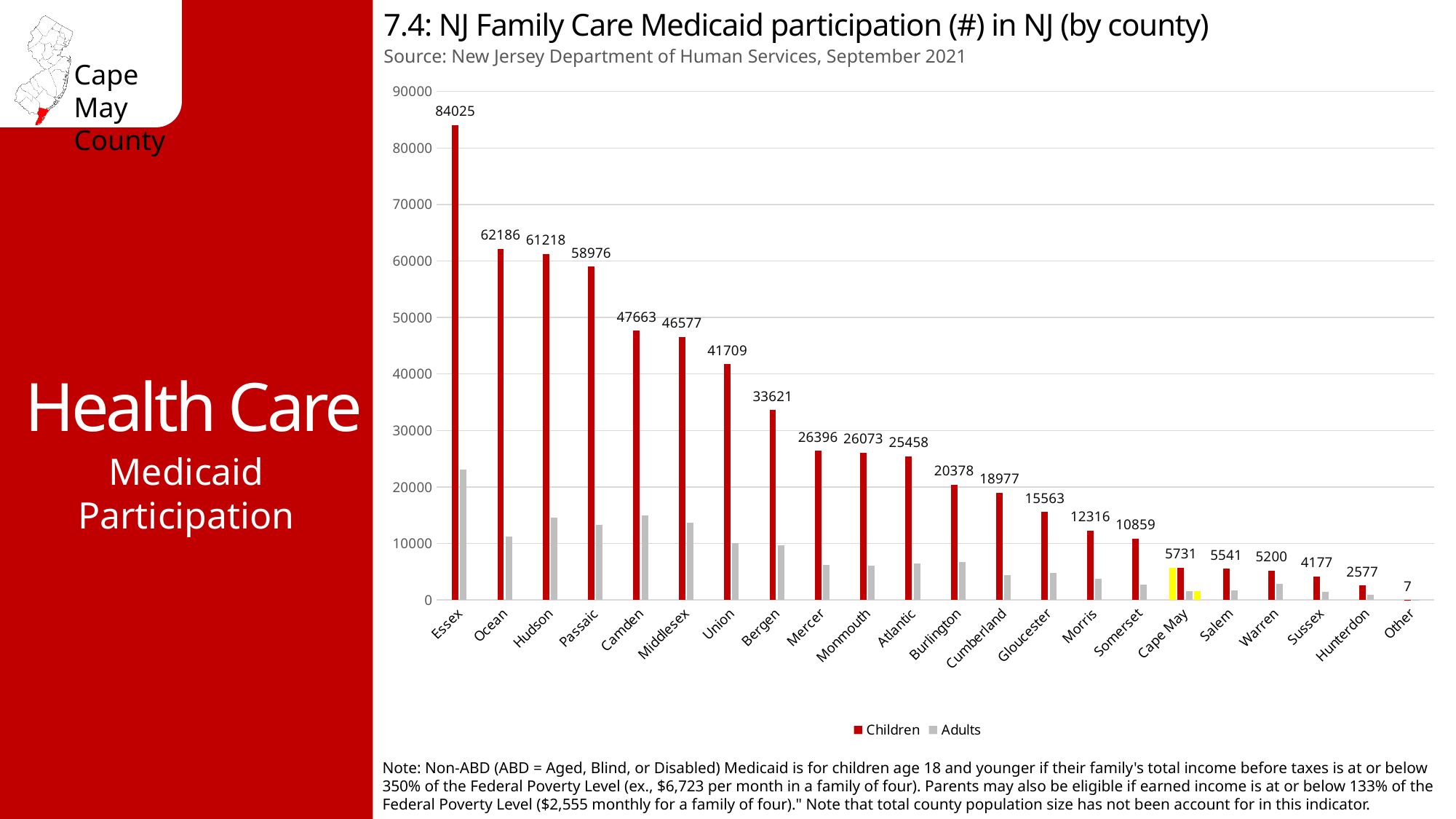
What kind of chart is shown? Bar chart What is the difference between the Children values for Ocean and Hudson? 968 Is the Adults value for Essex greater or less than 20000? greater What is the Children value for Essex? 84025 How many series does the legend list? 2 How many categories are shown on the x axis? 22 What is the Children value for Cape May? 5731 Is the Adults value for Hudson greater or less than 20000? less What is the Children value for Hunterdon? 2577 Which county has the highest Children value? Essex Which county has the lowest Children value (excluding Other)? Hunterdon Which has a larger Children value, Camden or Middlesex? Camden